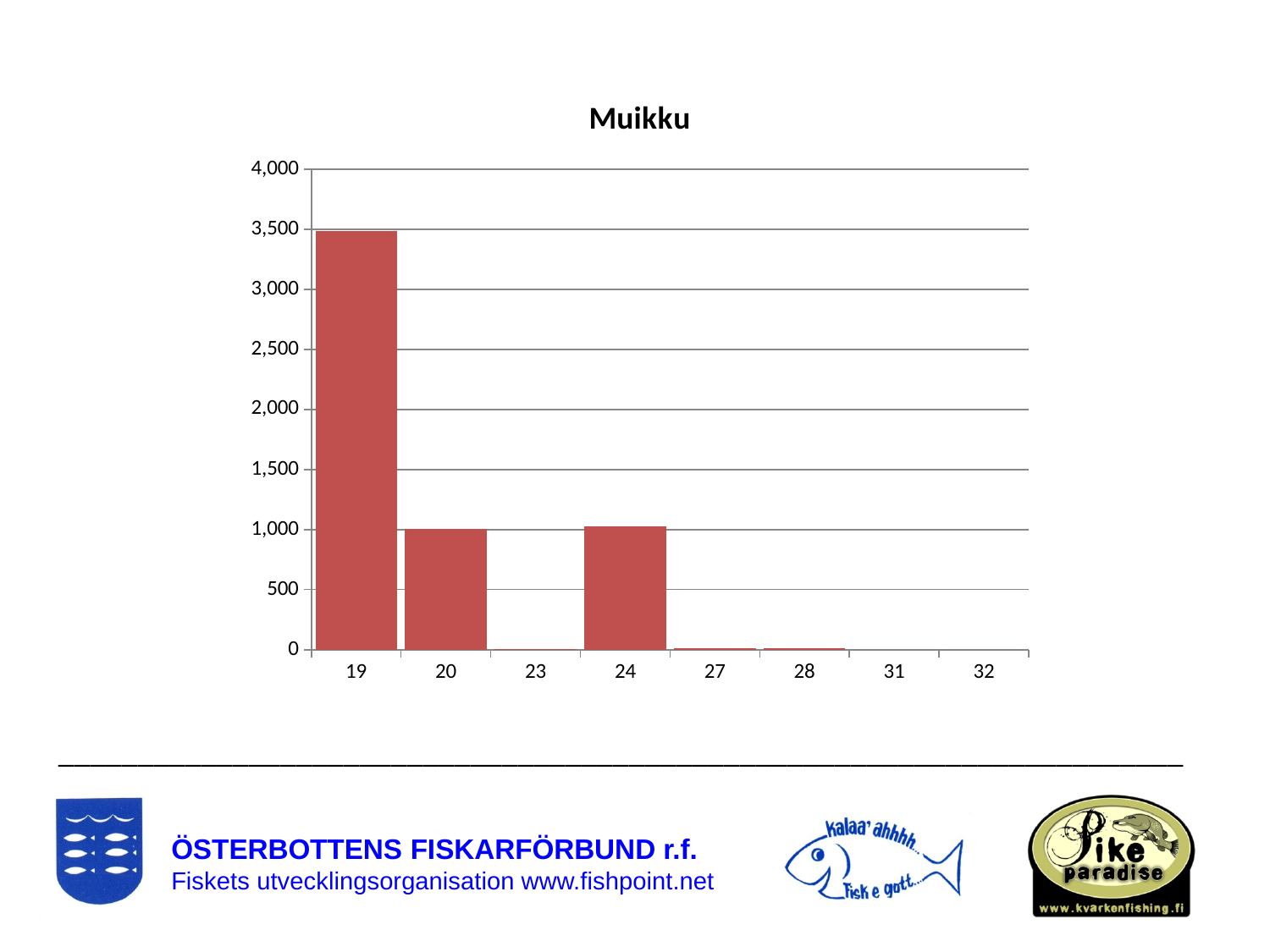
Is the value for category 24 greater or less than 500? greater Which category has the highest value in the chart? 19 Which has the larger value, category 24 or category 28? 24 Is the value for category 19 greater or less than 3,000? greater What is the highest value shown on the y axis of the chart? 4,000 How many categories are shown on the x axis of the chart? 8 Which has the larger value, category 19 or category 24? 19 Is the value for category 27 greater or less than 500? less What kind of chart is shown on the slide? bar chart What is the title of the chart? Muikku